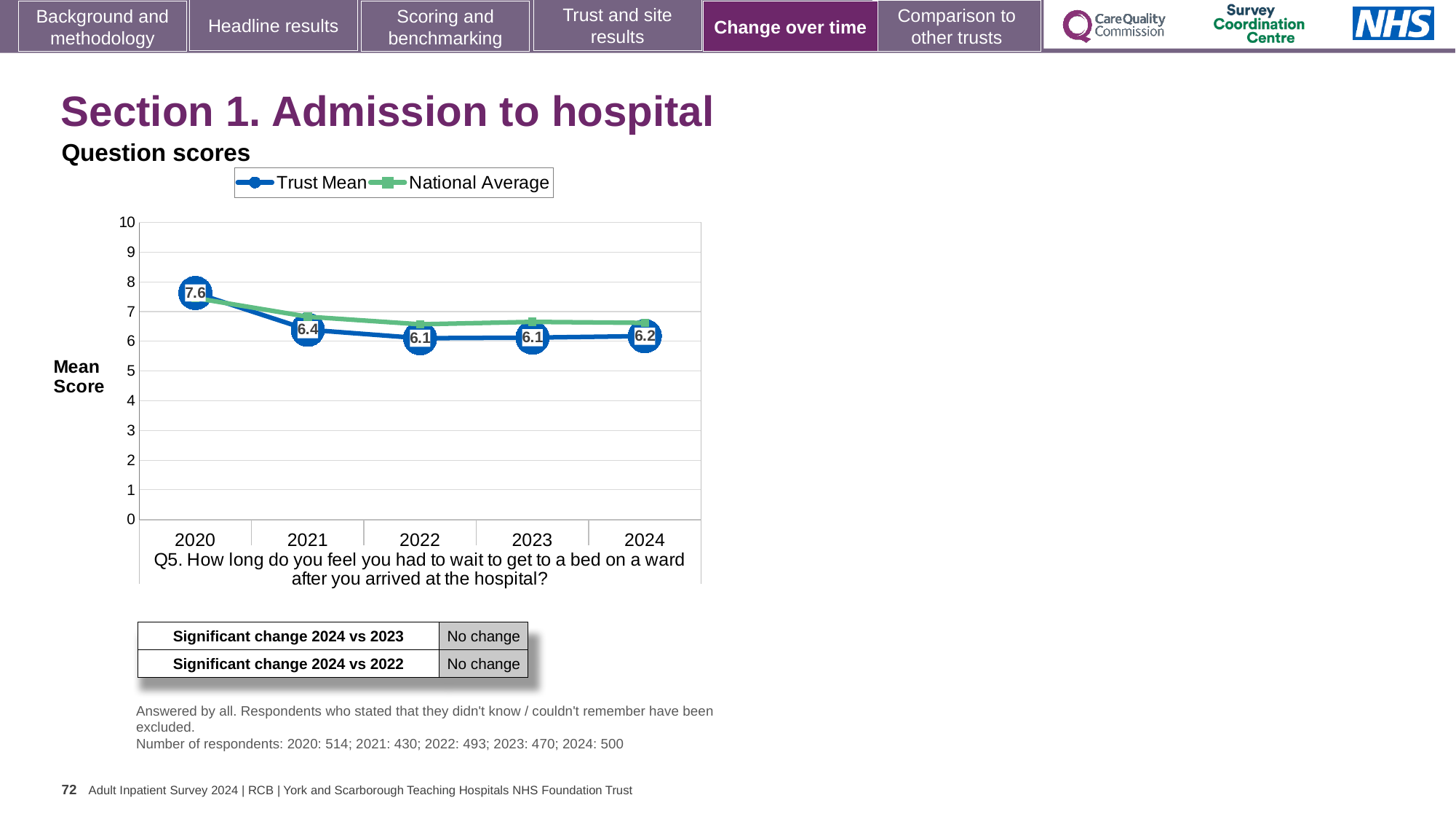
What is the difference between the Trust Mean score in 2020 and in 2024? 1.4 How many series does the legend list? 2 What is the Trust Mean score for 2024? 6.2 What kind of chart is shown on the slide? Line chart Which year has the larger Trust Mean score, 2021 or 2024? 2021 Is the National Average value for 2020 greater or less than 7? greater How many years are plotted on the x axis? 5 What is the Trust Mean score for 2020? 7.6 What is the lowest Trust Mean score shown on the chart? 6.1 Does the Trust Mean score rise or fall from 2020 to 2024? Fall What is the Trust Mean score for 2021? 6.4 In which year is the Trust Mean score highest? 2020